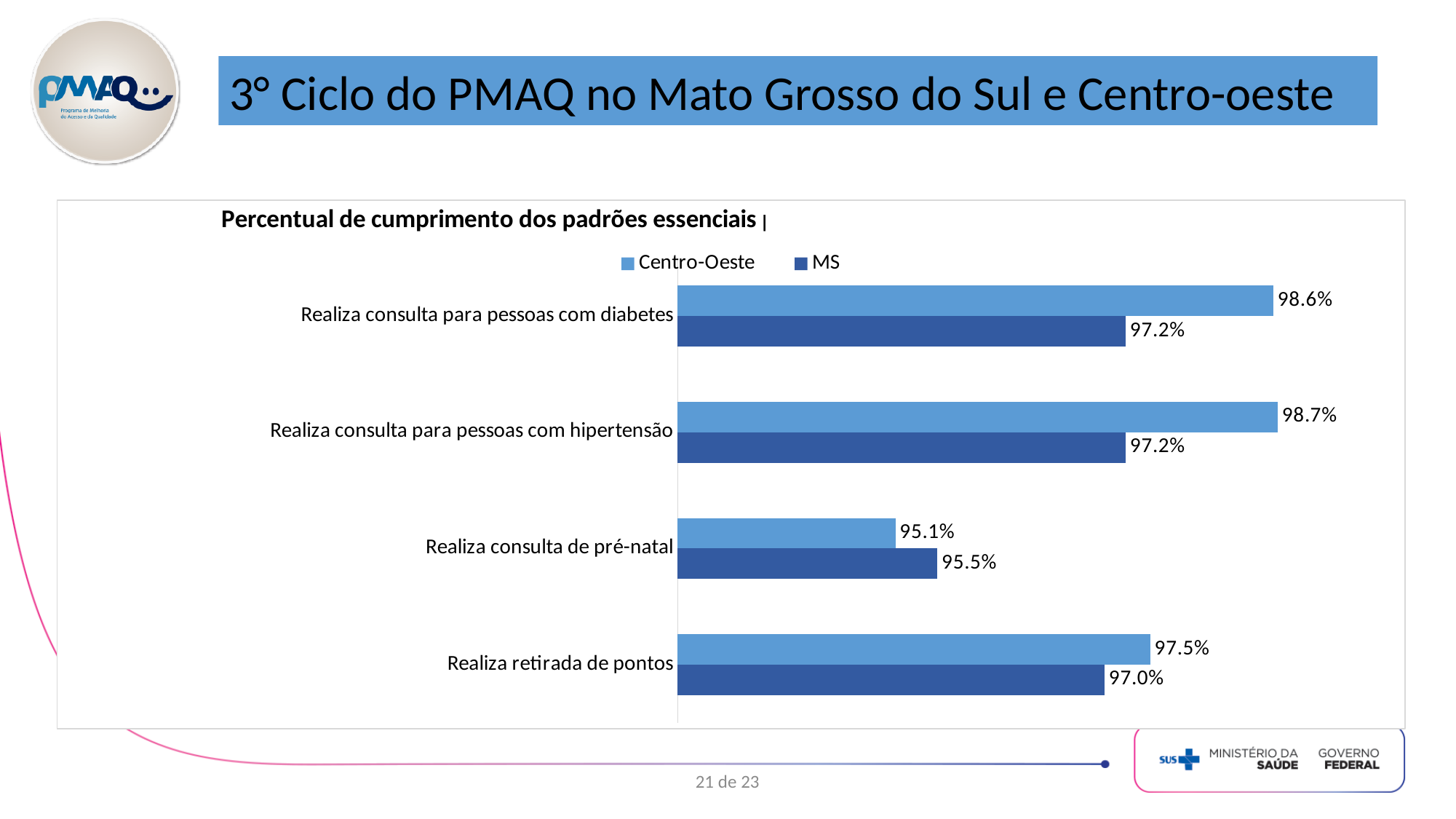
What kind of chart is shown on the slide? Bar chart What is the MS value for "Realiza retirada de pontos"? 97.0% What is the Centro-Oeste value for "Realiza consulta para pessoas com diabetes"? 98.6% What is the Centro-Oeste value for "Realiza consulta para pessoas com hipertensão"? 98.7% What is the title of the chart? Percentual de cumprimento dos padrões essenciais Which category has the lowest Centro-Oeste value? Realiza consulta de pré-natal How many series does the legend list? 2 Which category has the highest Centro-Oeste value? Realiza consulta para pessoas com hipertensão What is the difference between the Centro-Oeste and MS values for "Realiza consulta para pessoas com diabetes"? 1.4% For "Realiza consulta de pré-natal", which series has the larger value, Centro-Oeste or MS? MS How many categories are shown in the chart? 4 What is the MS value for "Realiza consulta de pré-natal"? 95.5%